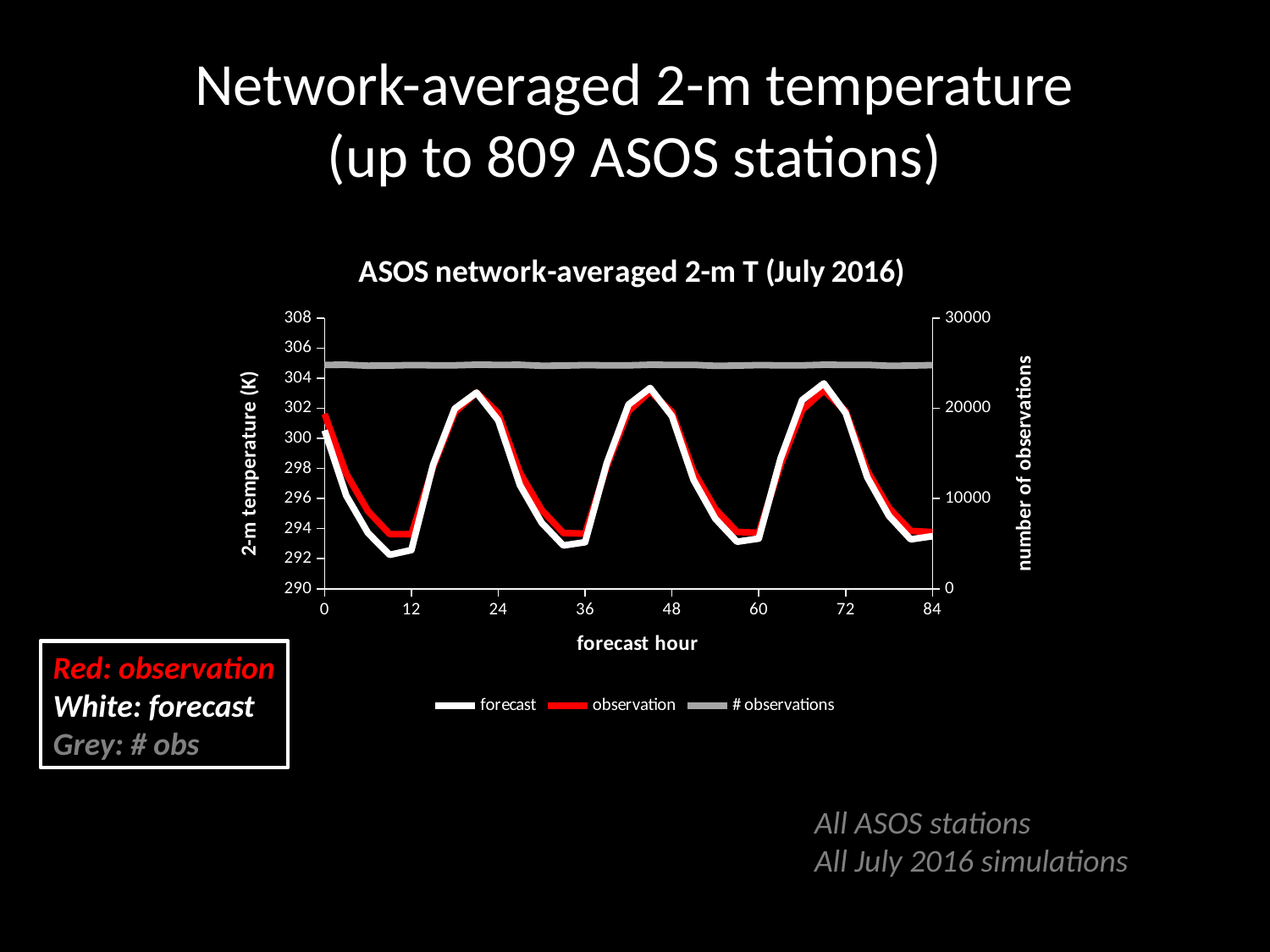
At forecast hour 12, which is larger, the forecast or the observation? observation Is the observation value at forecast hour 24 greater or less than 300 K? greater Does the forecast series rise or fall between forecast hour 0 and forecast hour 12? fall Is the forecast value at forecast hour 0 greater or less than 298 K? greater Is the value of the # observations series greater or less than 20000 across the forecast hours? greater What is the label of the x axis of the chart? forecast hour What is the title of the chart? ASOS network-averaged 2-m T (July 2016) At forecast hour 0, which is larger, the forecast or the observation? observation What kind of chart is shown on the slide? line chart How many series does the chart legend list? 3